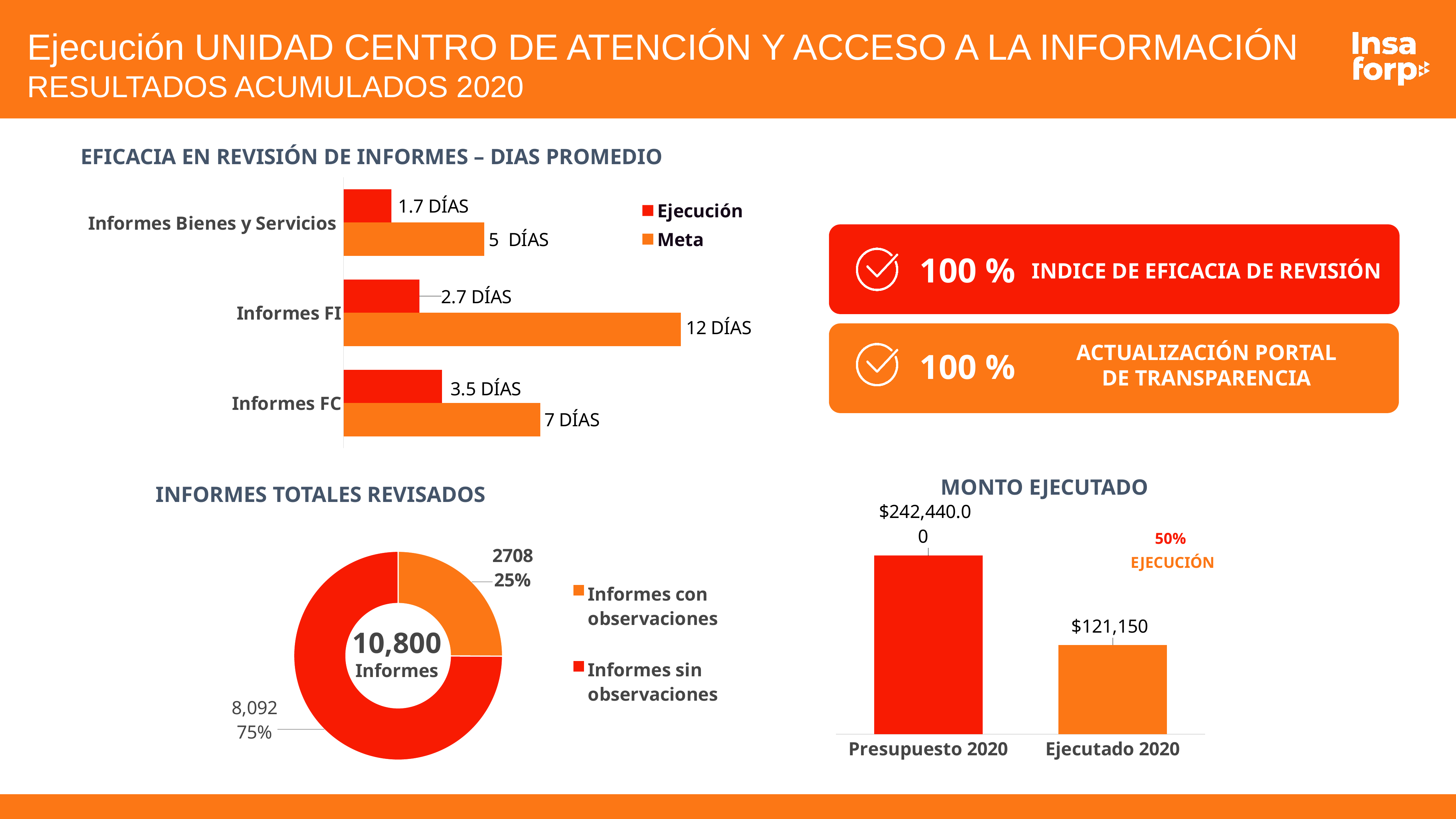
In the 'EFICACIA EN REVISIÓN DE INFORMES – DIAS PROMEDIO' chart, how many series does the legend list? 2 In the 'EFICACIA EN REVISIÓN DE INFORMES – DIAS PROMEDIO' chart, which category has the lowest Ejecución value? Informes Bienes y Servicios In the 'MONTO EJECUTADO' chart, which is larger, Presupuesto 2020 or Ejecutado 2020? Presupuesto 2020 In the 'EFICACIA EN REVISIÓN DE INFORMES – DIAS PROMEDIO' chart, which category has the highest Meta value? Informes FI In the 'EFICACIA EN REVISIÓN DE INFORMES – DIAS PROMEDIO' chart, what is the Ejecución value for Informes FI? 2.7 DÍAS In the 'MONTO EJECUTADO' chart, what is the value for Ejecutado 2020? $121,150 What kind of chart is 'EFICACIA EN REVISIÓN DE INFORMES – DIAS PROMEDIO'? Bar chart In the 'EFICACIA EN REVISIÓN DE INFORMES – DIAS PROMEDIO' chart, what is the Meta value for Informes Bienes y Servicios? 5 DÍAS In the 'INFORMES TOTALES REVISADOS' chart, what is the total number of informes shown in the centre? 10,800 In the 'INFORMES TOTALES REVISADOS' chart, how many informes are 'Informes con observaciones'? 2708 In the 'INFORMES TOTALES REVISADOS' chart, what share of the total is 'Informes sin observaciones'? 75% In the 'EFICACIA EN REVISIÓN DE INFORMES – DIAS PROMEDIO' chart, what is the difference between the Meta and Ejecución values for Informes FC? 3.5 DÍAS